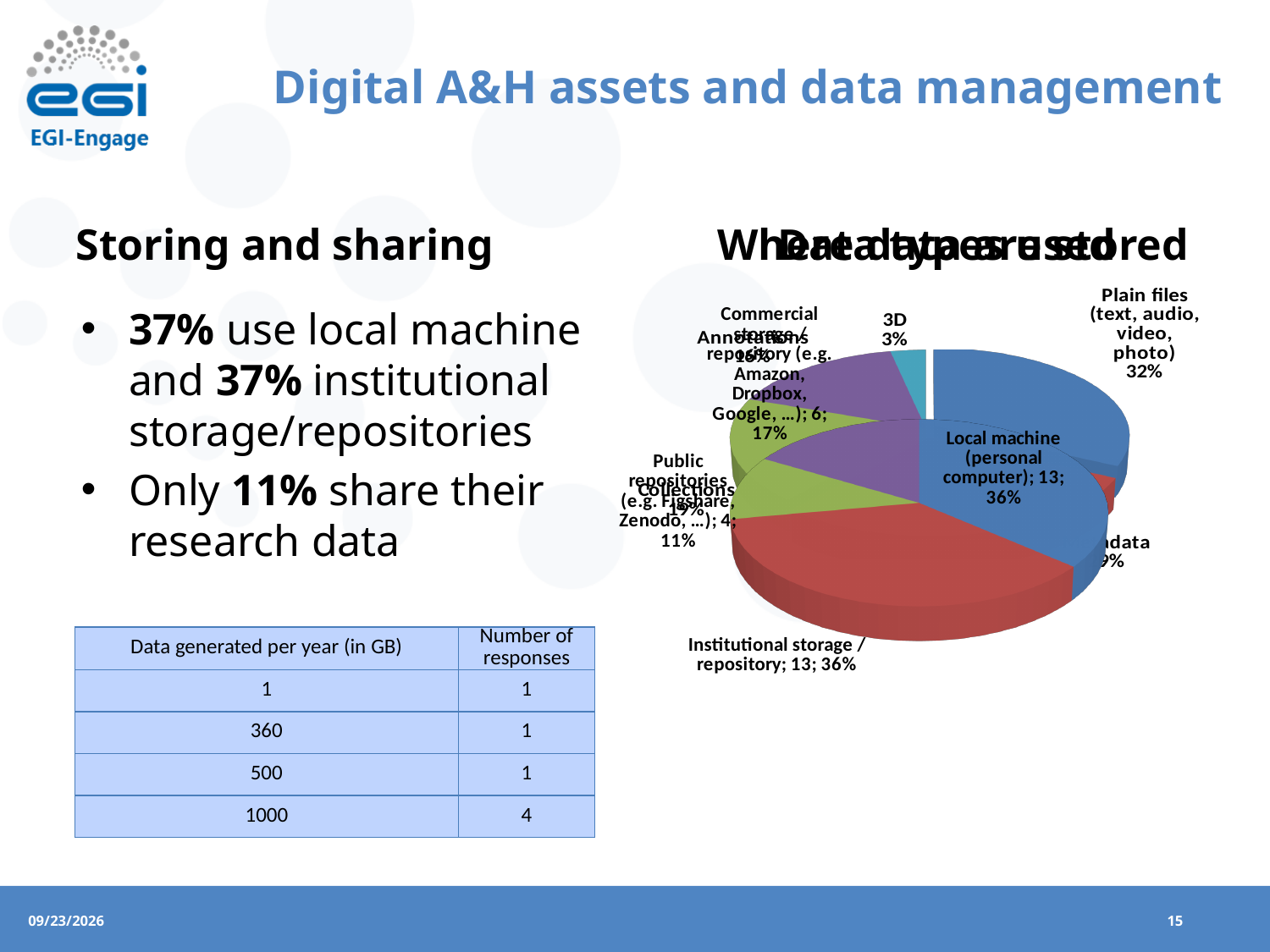
In the pie chart about where data are stored, which storage option has the smallest share? Public repositories (e.g. Figshare, Zenodo, ...) In the pie chart about data types used, what percentage is shown for Plain files (text, audio, video, photo)? 32% What kind of chart is used on the slide to show where data are stored? pie chart In the pie chart about data types used, what percentage is shown for 3D? 3% In the pie chart about where data are stored, what percentage is shown for Local machine (personal computer)? 36% In the pie chart about where data are stored, how many responses are shown for Institutional storage / repository? 13 In the pie chart about where data are stored, which has more responses: Local machine (personal computer) or Commercial storage / repository? Local machine (personal computer) In the pie chart about where data are stored, what percentage is shown for Commercial storage / repository (e.g. Amazon, Dropbox, Google, ...)? 17% In the pie chart about where data are stored, what is the total number of responses across all categories? 36 In the pie chart about where data are stored, what is the difference in number of responses between Commercial storage / repository and Public repositories? 2 In the pie chart about where data are stored, how many responses are shown for Public repositories (e.g. Figshare, Zenodo, ...)? 4 How many categories are shown in the pie chart about where data are stored? 4